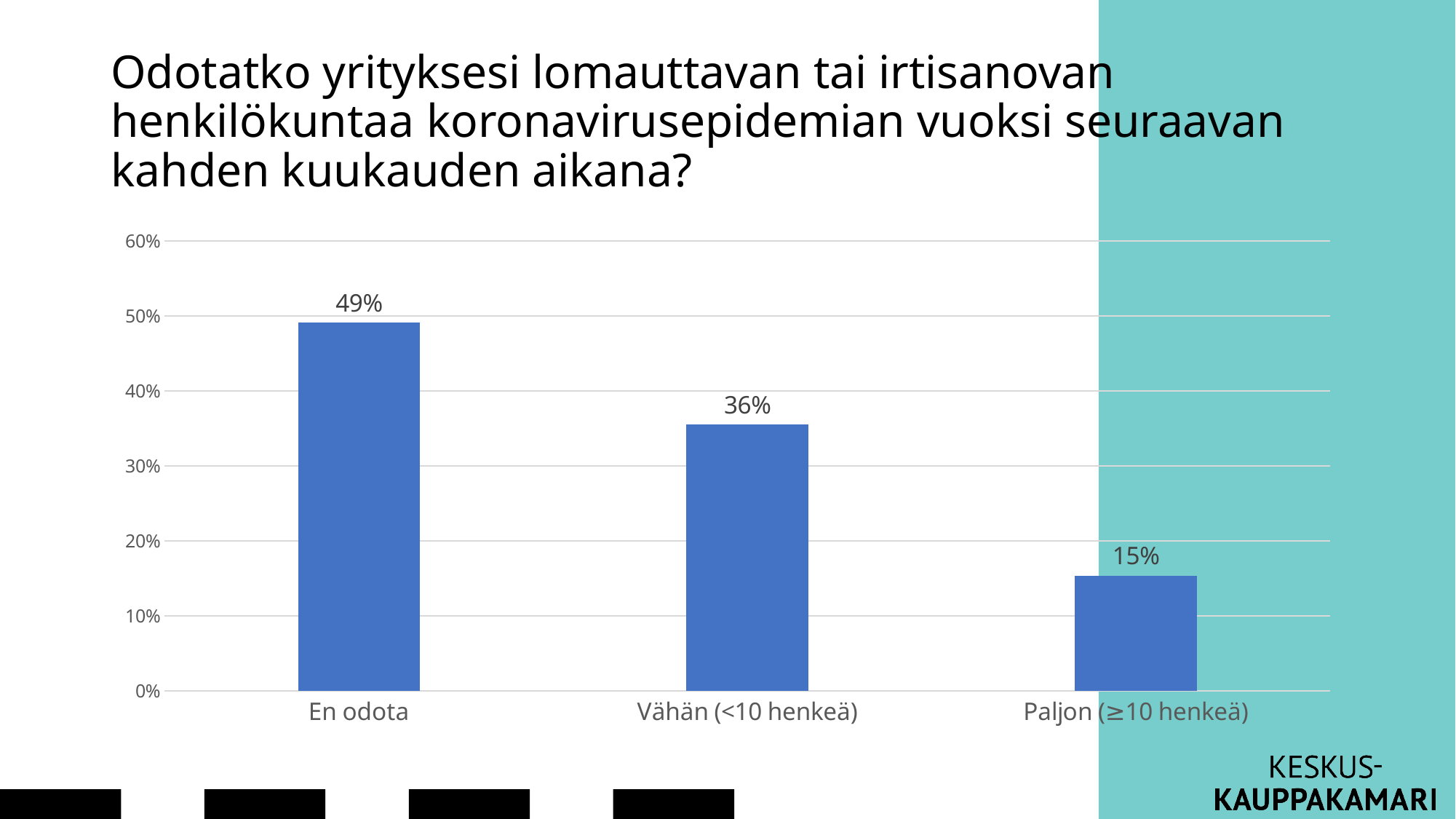
What kind of chart is shown on the slide? bar chart Is the value for "Vähän (<10 henkeä)" greater or less than 40%? less What is the value for "Vähän (<10 henkeä)"? 36% What is the value for "En odota"? 49% What is the difference between the values for "En odota" and "Vähän (<10 henkeä)"? 13% Do the values rise or fall from left to right along the x axis? fall Which category has the highest value? En odota What is the difference between the values for "Vähän (<10 henkeä)" and "Paljon (≥10 henkeä)"? 21% Which category has the lowest value? Paljon (≥10 henkeä) How many categories are shown in the chart? 3 Which is larger, the value for "Vähän (<10 henkeä)" or the value for "Paljon (≥10 henkeä)"? Vähän (<10 henkeä) What is the value for "Paljon (≥10 henkeä)"? 15%